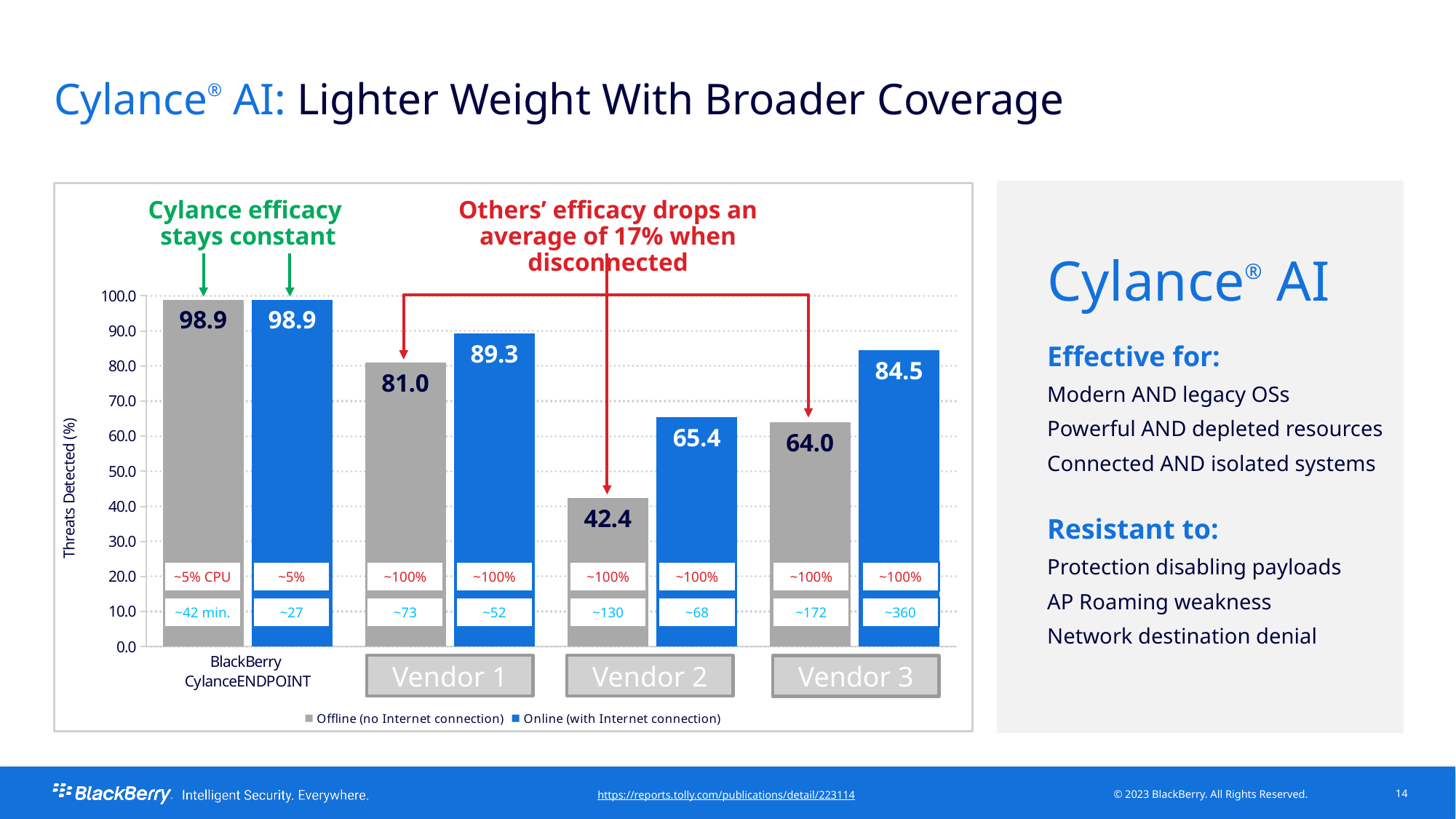
Which category has the lowest Offline (no Internet connection) value? Vendor 2 What is the difference between the Online and Offline values for Vendor 3? 20.5 Which is larger: the Offline value for Vendor 1 or the Offline value for Vendor 3? Vendor 1 How many vendor categories are shown on the x axis of the chart? 4 What is the Online (with Internet connection) value for Vendor 1? 89.3 How many series does the chart legend list? 2 What kind of chart is shown on the slide? Bar chart What is the difference between the Online and Offline values for Vendor 2? 23.0 Which category has the highest Online (with Internet connection) value? BlackBerry CylanceENDPOINT What is the Online (with Internet connection) threats detected value for Vendor 3? 84.5 What is the label of the y axis of the chart? Threats Detected (%) What is the Offline (no Internet connection) threats detected value for Vendor 2? 42.4